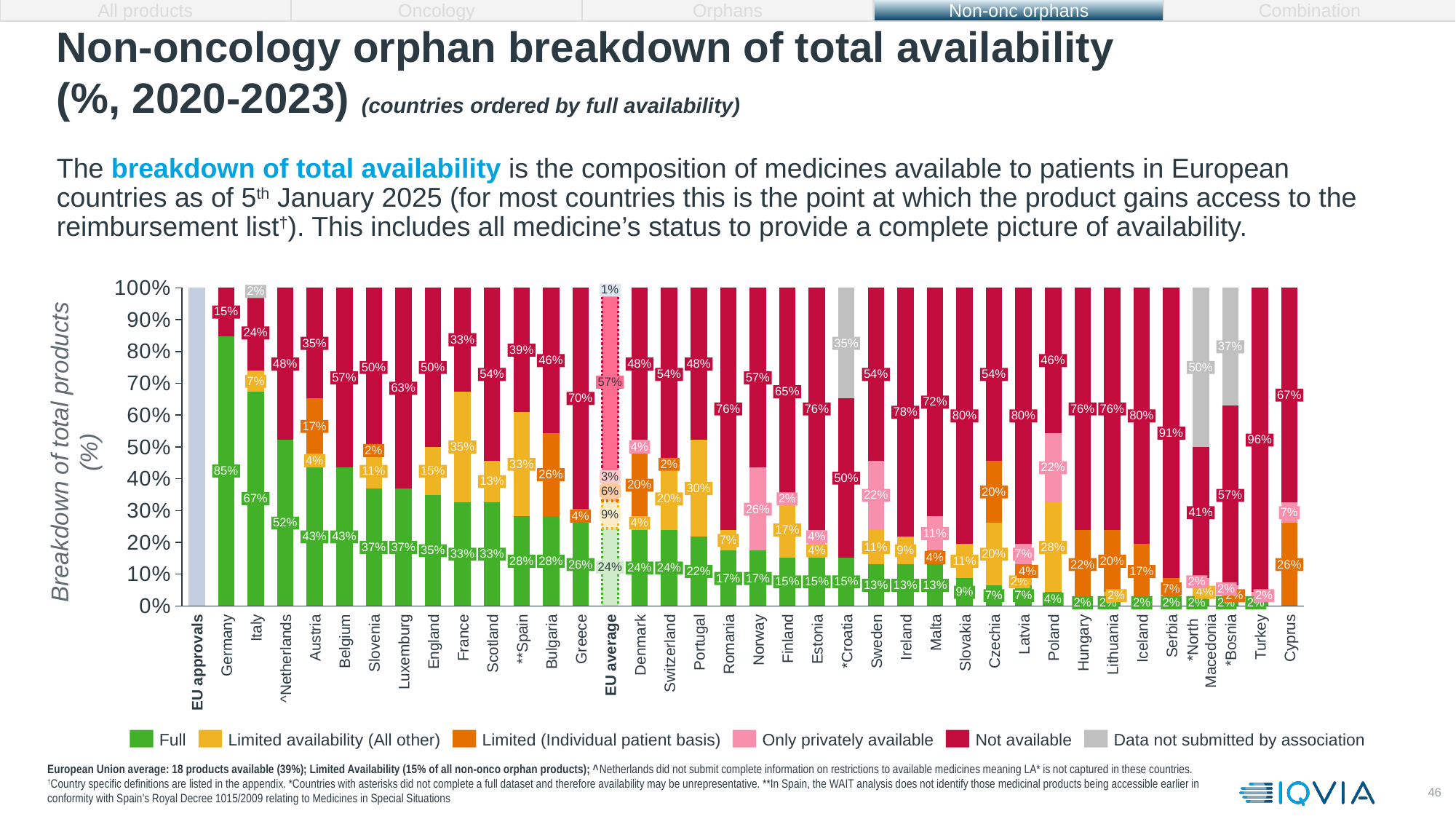
What is the Data not submitted by association value for *Croatia? 35% What is the difference in Full availability between Germany and Italy? 18 percentage points What is the Only privately available value for Poland? 22% What is the Not available value for Serbia? 91% What is the Limited (Individual patient basis) value for Cyprus? 26% What is the Not available value for Turkey? 96% What is the Full availability value for the EU average? 24% Which country has the highest Full availability share? Germany Which has a larger Full availability share, ^Netherlands or Belgium? ^Netherlands What type of chart is shown on the slide? Stacked bar chart How many series does the legend list? 6 What is the Full availability value for Germany? 85%